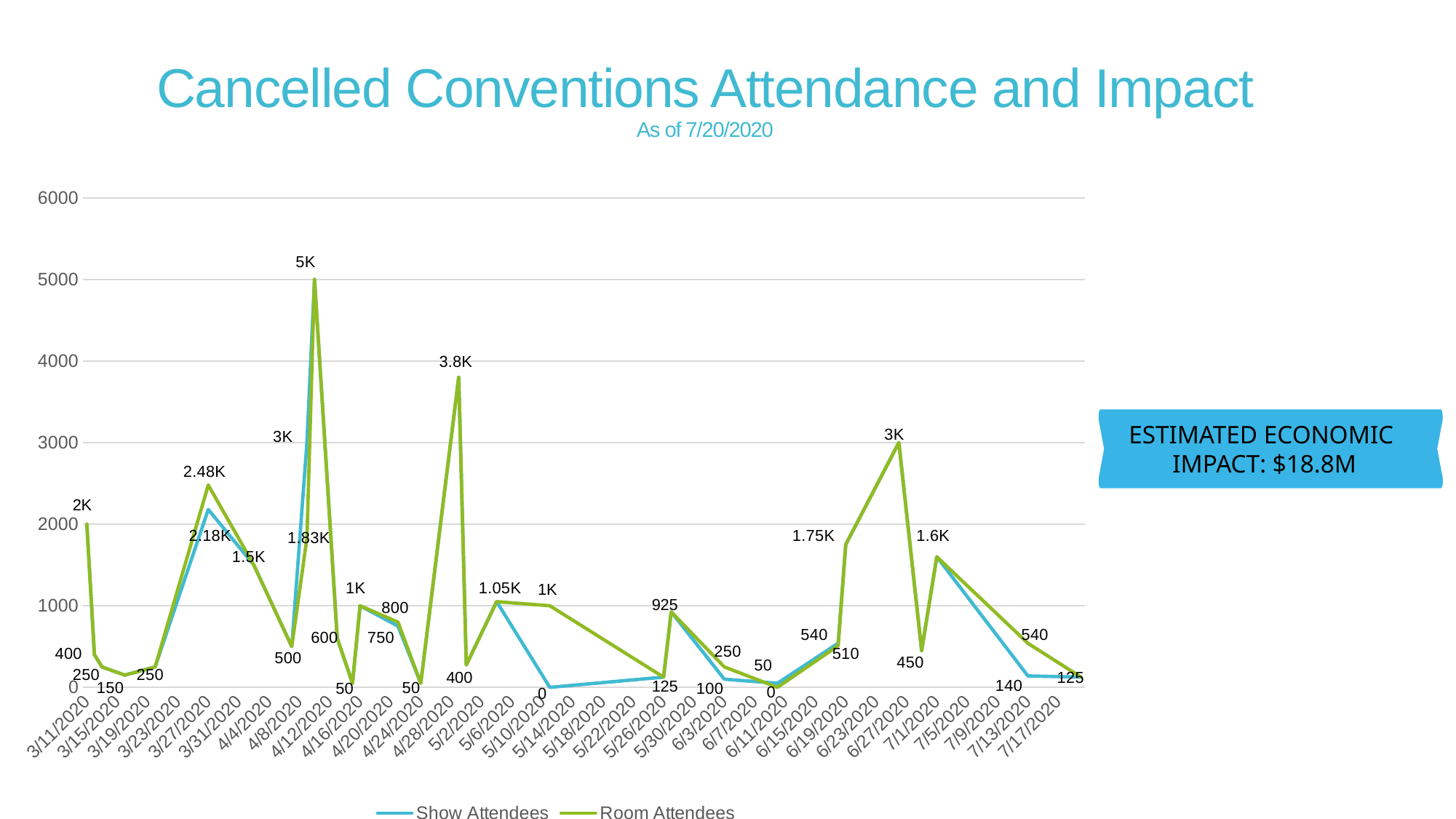
What is the Room Attendees value on 3/11/2020? 2K On 3/27/2020, how much higher is Room Attendees (2.48K) than Show Attendees (2.18K)? 300 How many series does the legend list? 2 What is the highest value labeled on the chart? 5K What are the two series named in the legend? Show Attendees and Room Attendees Between 7/1/2020 and 7/17/2020, do the values rise or fall? fall What kind of chart is shown on the slide? line chart What estimated economic impact is stated on the slide? $18.8M Is the Show Attendees value on 3/27/2020 greater or less than 2000? greater